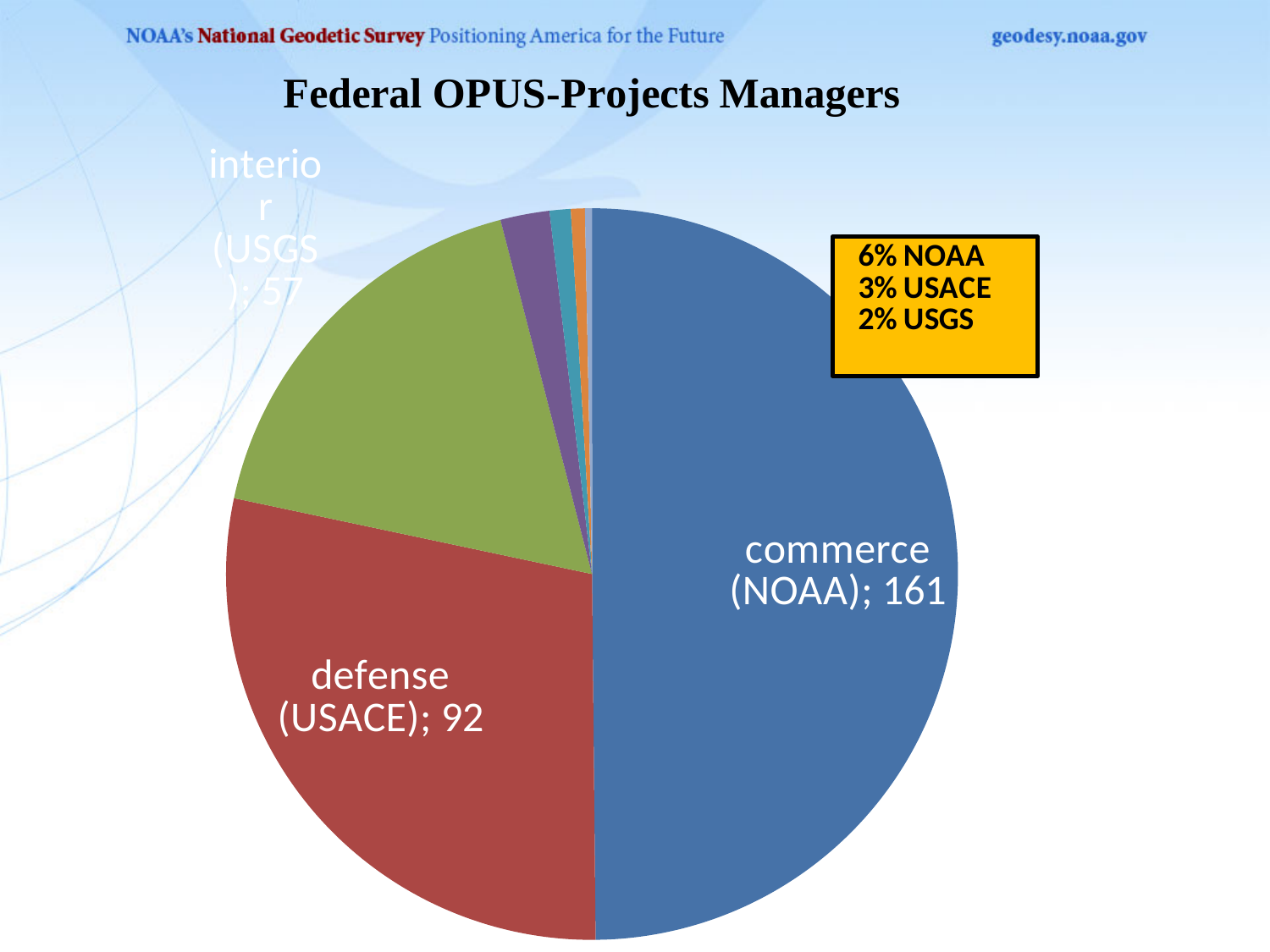
Which is larger, the value for defense (USACE) or the value for interior (USGS)? defense (USACE) What is the title of the chart? Federal OPUS-Projects Managers What is the value for interior (USGS)? 57 What is the difference between the values for defense (USACE) and interior (USGS)? 35 Which category has the largest slice of the pie? commerce (NOAA) What colour is the commerce (NOAA) slice? blue What kind of chart is shown on the slide? pie chart Which is larger, the value for defense (USACE) or the value for commerce (NOAA)? commerce (NOAA) What is the value for defense (USACE)? 92 What is the difference between the values for commerce (NOAA) and defense (USACE)? 69 What percentage is listed for USACE in the yellow box? 3% What is the value for commerce (NOAA)? 161